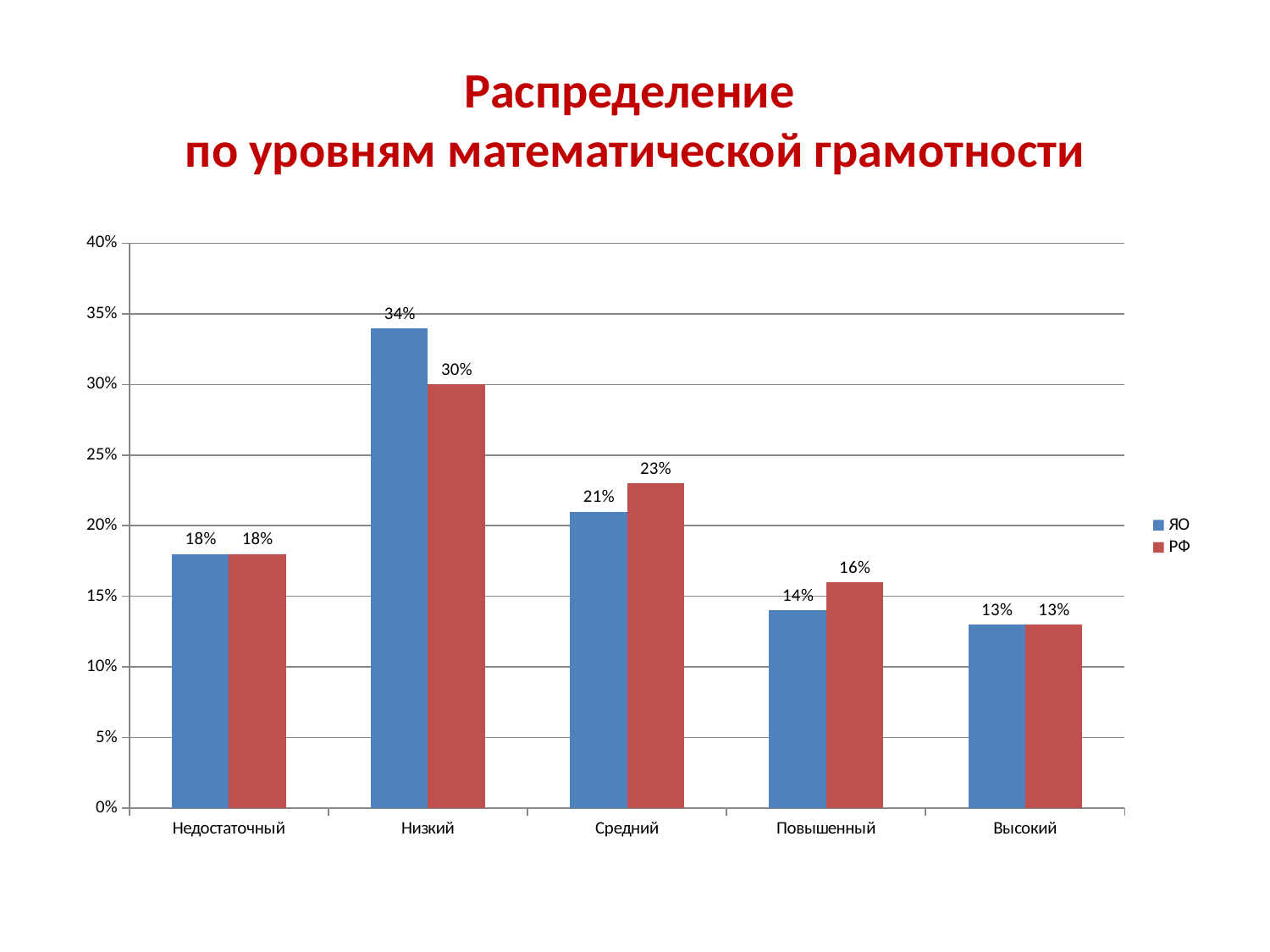
How many categories are shown on the x axis? 5 How many series does the legend list? 2 Which category has the highest value for ЯО? Низкий What is the value for РФ in the Средний category? 23% What kind of chart is shown on the slide? bar chart What is the value for ЯО in the Низкий category? 34% Which category has the lowest value for РФ? Высокий What is the difference between the ЯО and РФ values in the Низкий category? 4% What is the value for РФ in the Повышенный category? 16% Which is larger in the Средний category, the value for ЯО or for РФ? РФ Which colour represents the РФ series? red Is the value for ЯО in the Низкий category greater or less than 30%? greater